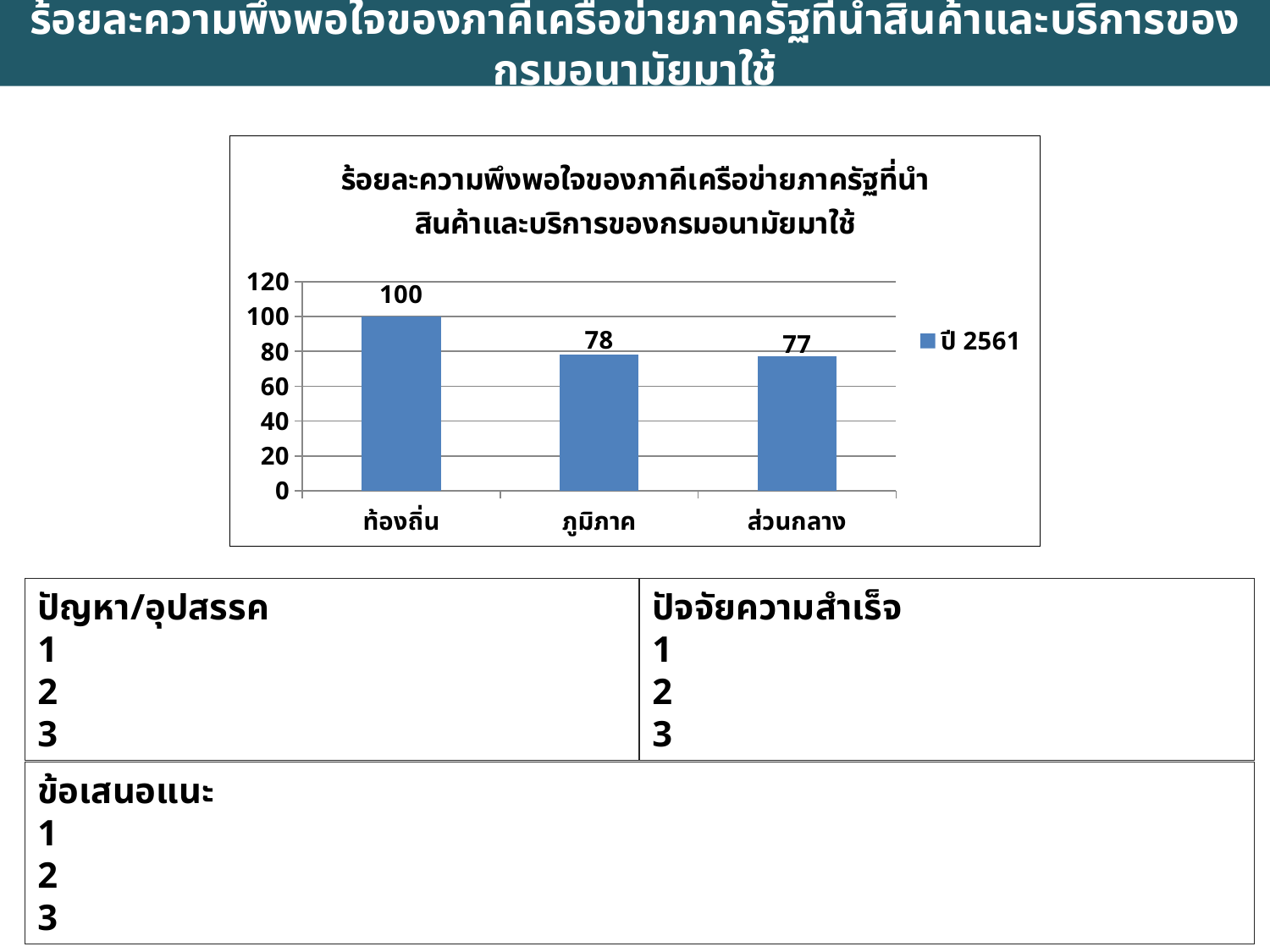
Which is larger, the value for ท้องถิ่น or the value for ส่วนกลาง? ท้องถิ่น How many categories are shown on the x axis? 3 What is the difference between the values for ภูมิภาค and ส่วนกลาง? 1 What is the value for ส่วนกลาง? 77 Which category has the lowest value? ส่วนกลาง What is the value for ภูมิภาค? 78 What kind of chart is shown on the slide? bar chart What is the value for ท้องถิ่น? 100 Is the value for ภูมิภาค greater or less than 80? less Which category has the highest value? ท้องถิ่น How many series does the legend list? 1 What is the difference between the values for ท้องถิ่น and ภูมิภาค? 22